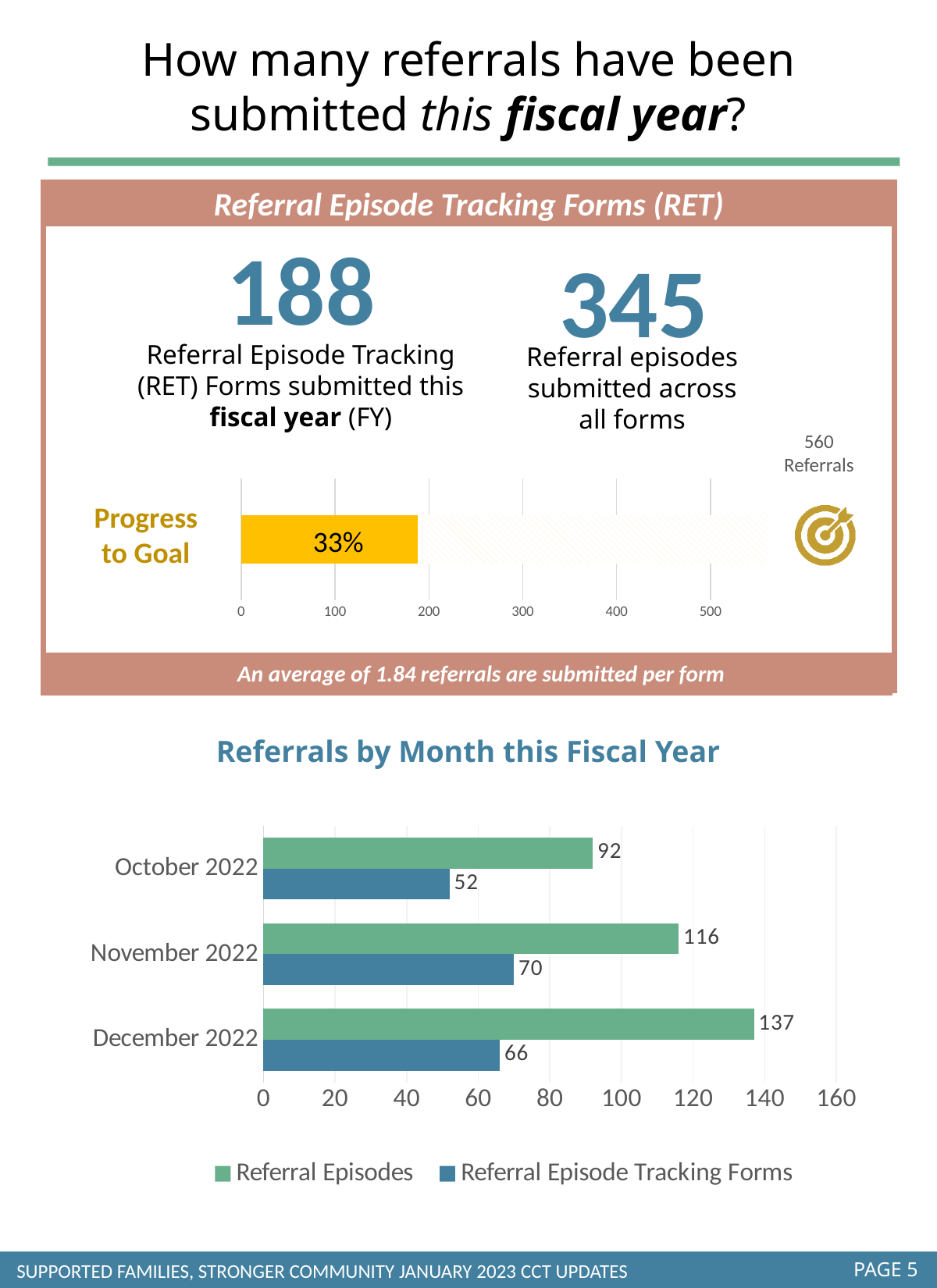
In the 'Referrals by Month this Fiscal Year' chart, do Referral Episodes rise or fall from October 2022 to December 2022? Rise In the 'Referrals by Month this Fiscal Year' chart, what is the difference between Referral Episodes and Referral Episode Tracking Forms in December 2022? 71 What type of chart is 'Referrals by Month this Fiscal Year'? Bar chart In the 'Referrals by Month this Fiscal Year' chart, which month has the highest number of Referral Episodes? December 2022 In the 'Progress to Goal' chart, what percentage is printed on the bar? 33% In the 'Referrals by Month this Fiscal Year' chart, how many Referral Episode Tracking Forms were submitted in November 2022? 70 In the 'Referrals by Month this Fiscal Year' chart, what is the value of Referral Episode Tracking Forms for October 2022? 52 In the 'Referrals by Month this Fiscal Year' chart, how many series does the legend list? 2 In the 'Referrals by Month this Fiscal Year' chart, which month has the lowest number of Referral Episode Tracking Forms? October 2022 In the 'Referrals by Month this Fiscal Year' chart, how many months are shown? 3 In the 'Referrals by Month this Fiscal Year' chart, which is larger: Referral Episode Tracking Forms in November 2022 or in December 2022? November 2022 In the 'Referrals by Month this Fiscal Year' chart, what is the value of Referral Episodes for December 2022? 137